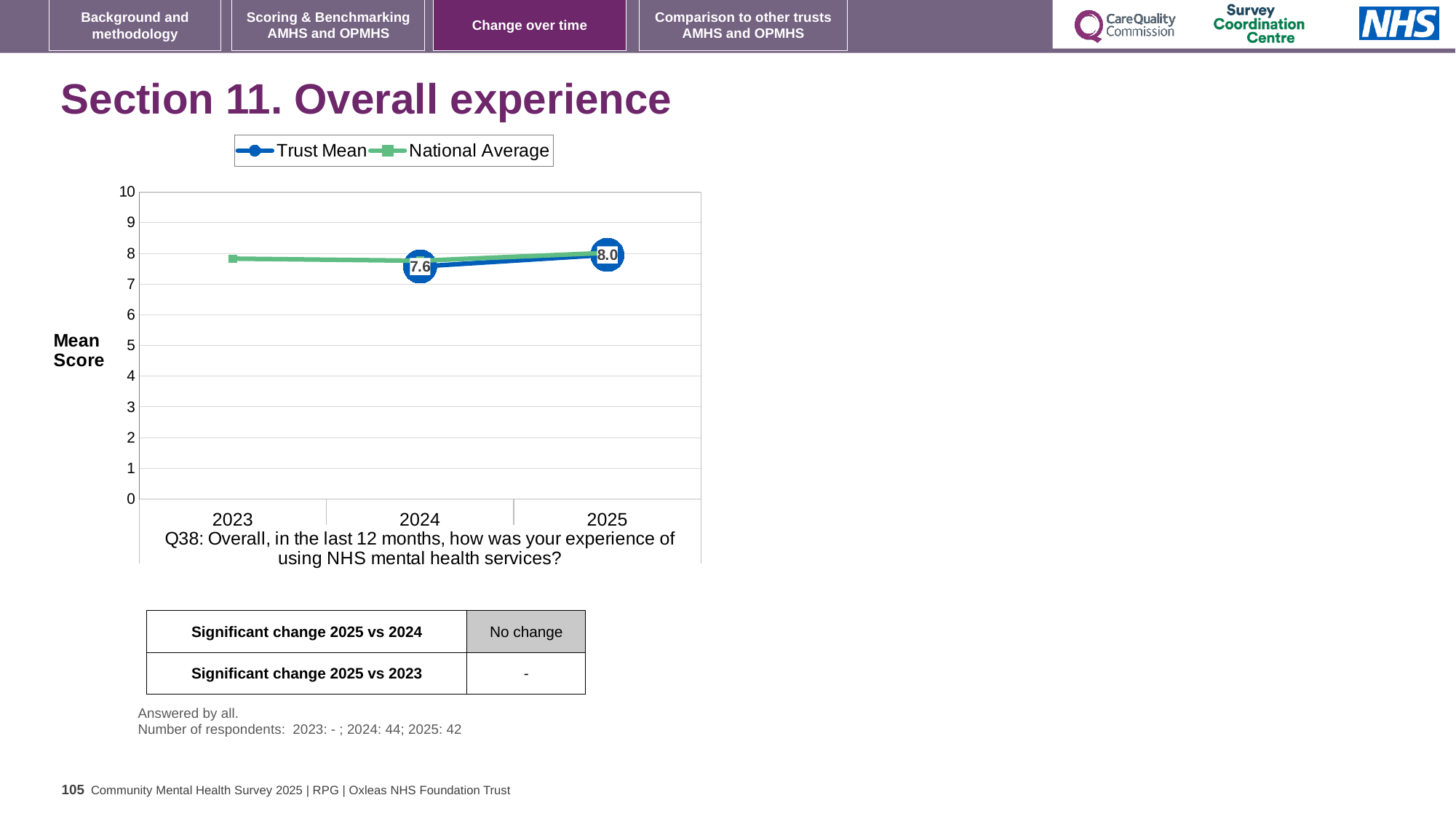
What is the Trust Mean value for 2024? 7.6 What are the two series named in the legend? Trust Mean and National Average Is the Trust Mean value for 2025 greater or less than 9? less What is the label on the y axis? Mean Score How many series does the legend list? 2 How many years are shown on the x axis? 3 Does the Trust Mean rise or fall from 2024 to 2025? rise Which year has the higher Trust Mean, 2024 or 2025? 2025 Is the National Average value for 2023 greater or less than 5? greater What kind of chart is shown on the slide? line chart What is the Trust Mean value for 2025? 8.0 By how much did the Trust Mean change from 2024 to 2025? 0.4